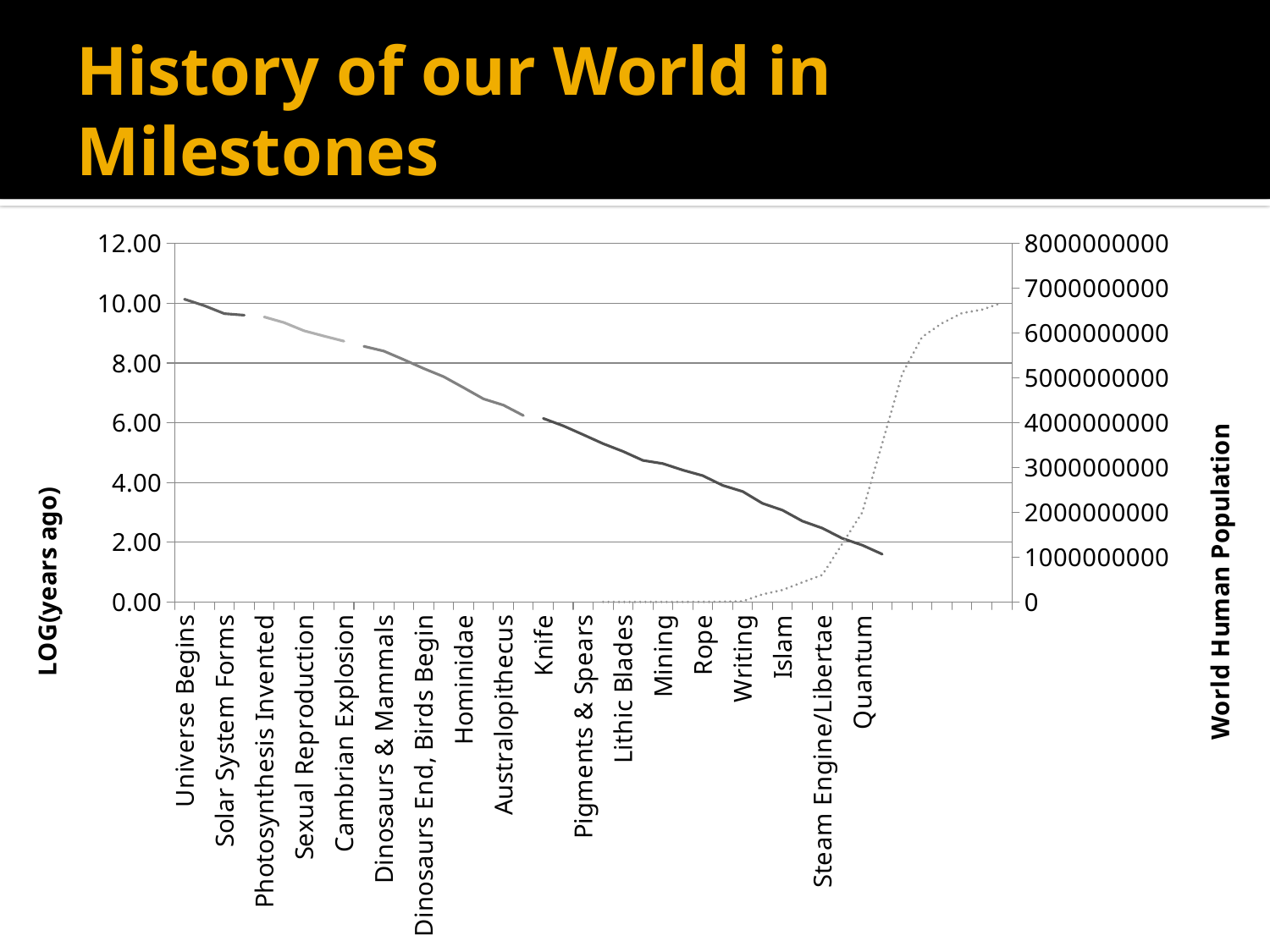
What is the title of the right vertical axis? World Human Population Is the LOG(years ago) value for Writing greater or less than 4.00? less What is the title of the left vertical axis? LOG(years ago) What kind of chart is shown on the slide? line chart Which labeled milestone has the highest LOG(years ago) value? Universe Begins Is the LOG(years ago) value for Universe Begins greater or less than 8.00? greater Does the LOG(years ago) line rise or fall as you move from Universe Begins toward Quantum along the x axis? fall Which has the larger LOG(years ago) value, Knife or Rope? Knife Is the LOG(years ago) value for Cambrian Explosion greater or less than 8.00? greater Which labeled milestone has the lowest LOG(years ago) value? Quantum